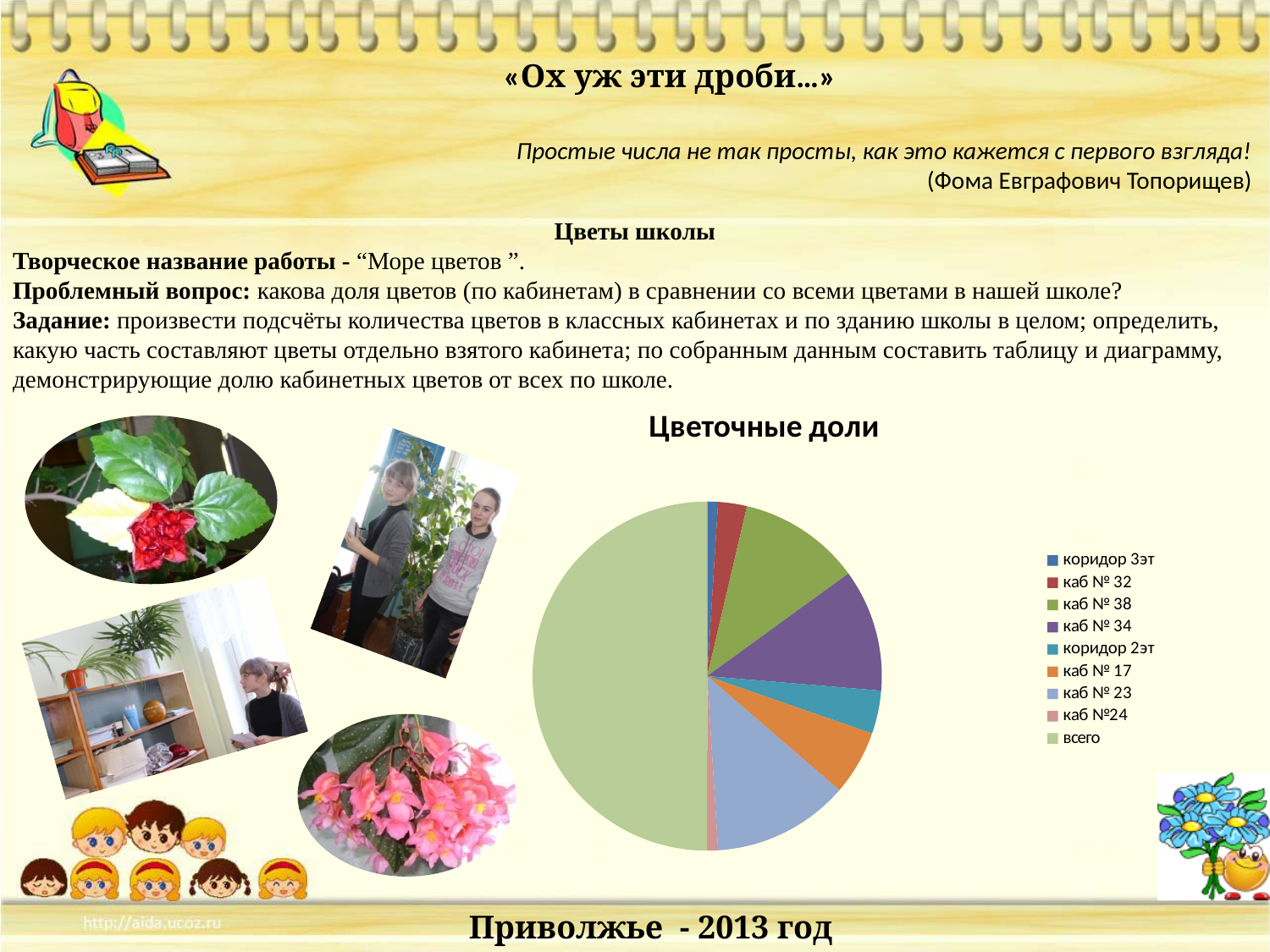
Which slice is larger, всего or каб № 38? всего Which slice is larger, каб № 34 or коридор 3эт? каб № 34 How many entries does the chart's legend list? 9 What is the title of the chart? Цветочные доли Which slice is larger, каб № 23 or коридор 2эт? каб № 23 What kind of chart is shown on the slide? pie chart What colour is used for the всего slice in the pie chart? light green Which category has the largest slice in the pie chart? всего